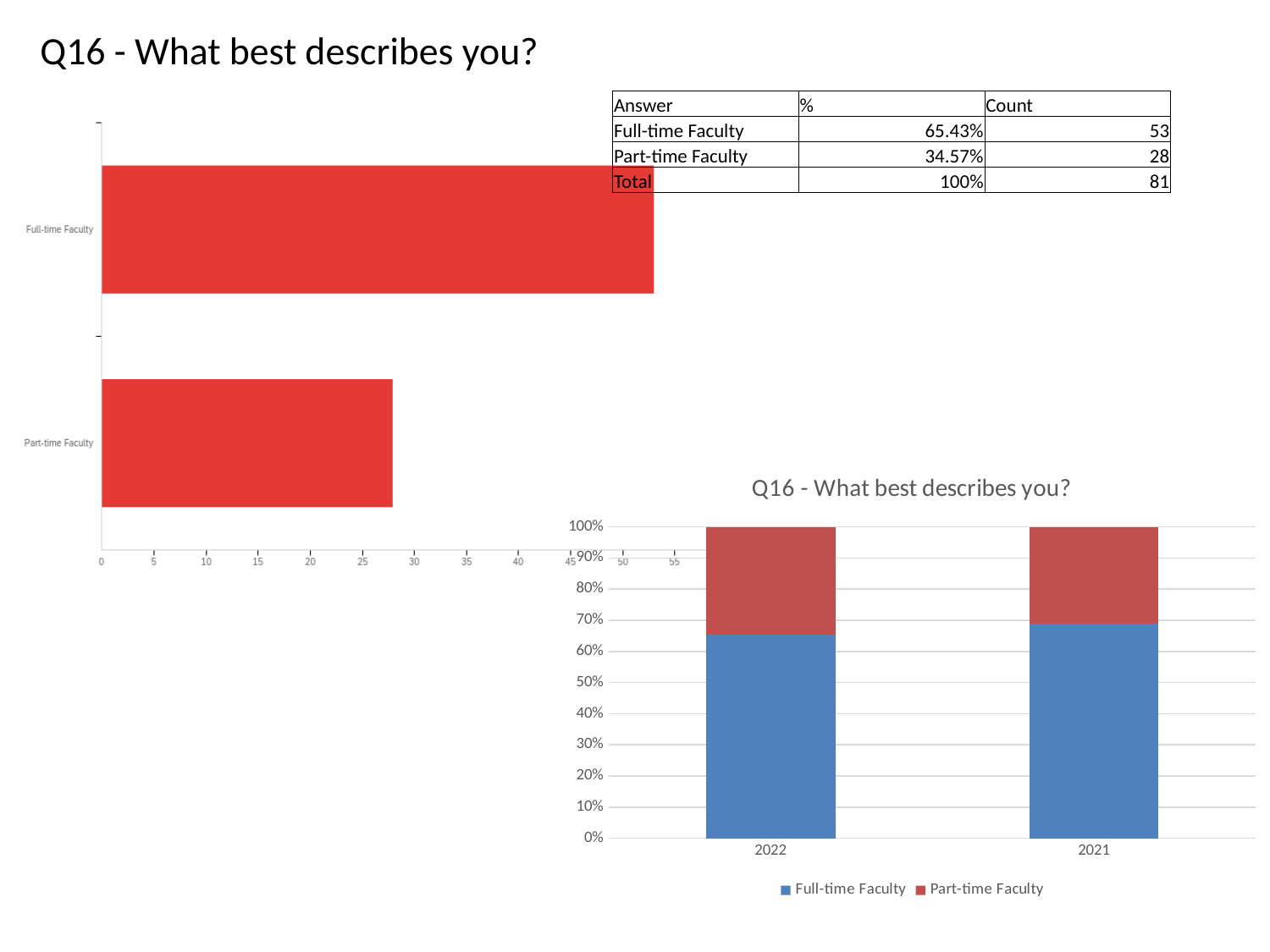
In the chart on the left of the slide, is the value for Full-time Faculty greater or less than 50? greater In the chart on the left of the slide, which category has the shortest bar? Part-time Faculty How many series does the legend of the chart titled 'Q16 - What best describes you?' list? 2 What is the title of the stacked bar chart on the right of the slide? Q16 - What best describes you? In the chart titled 'Q16 - What best describes you?', is the Full-time Faculty share for 2022 greater or less than 60%? greater In the chart on the left of the slide, is the value for Part-time Faculty greater or less than 30? less How many categories does the chart on the left of the slide show? 2 In the chart titled 'Q16 - What best describes you?', which colour represents Part-time Faculty? red In the chart on the left of the slide, which category has the longest bar? Full-time Faculty How many categories are shown on the x axis of the chart titled 'Q16 - What best describes you?'? 2 What kind of chart is the chart on the left of the slide? bar chart